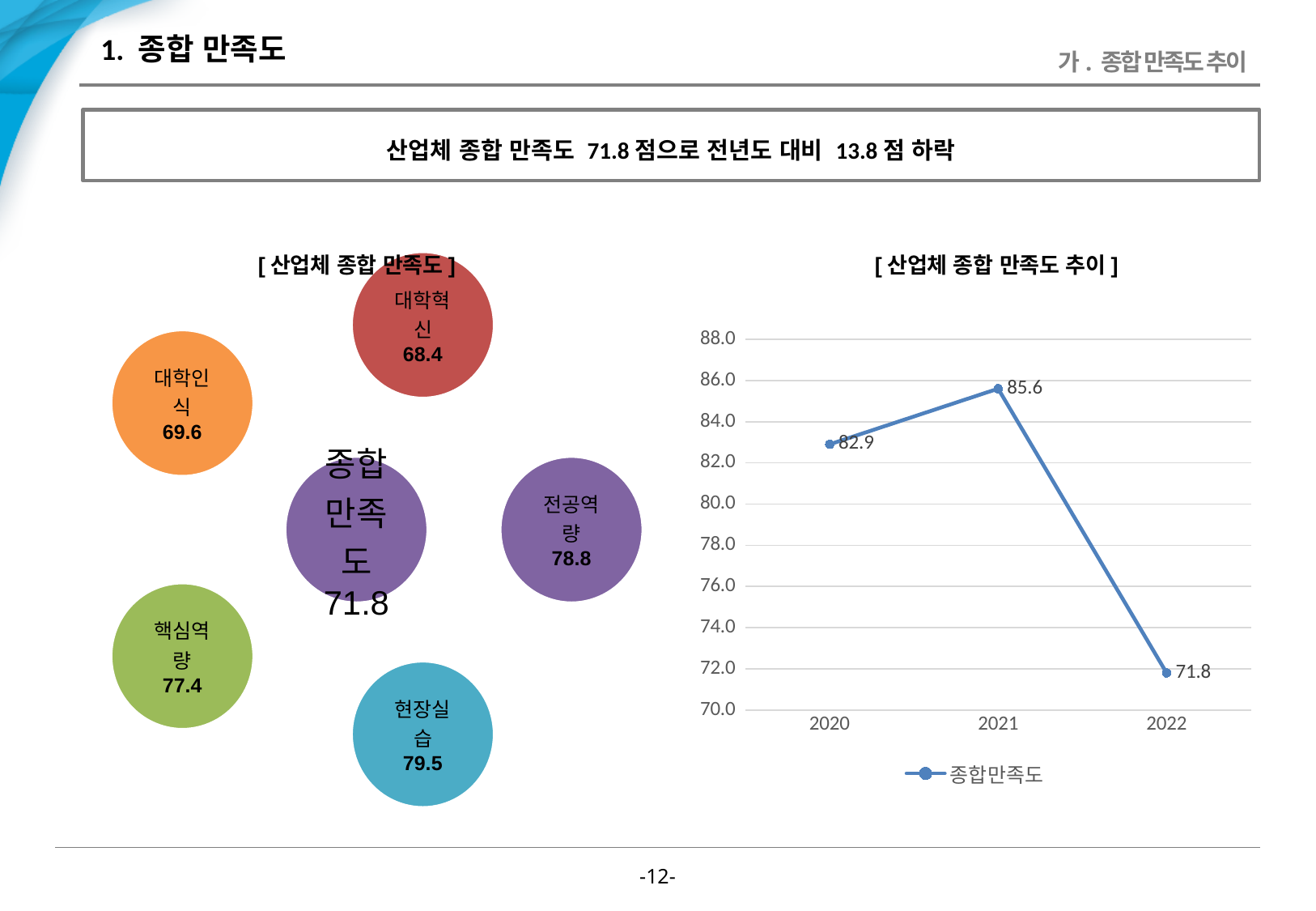
In the '[ 산업체 종합 만족도 추이 ]' chart, what is the value for 2022? 71.8 In the '[ 산업체 종합 만족도 추이 ]' chart, how many series does the legend list? 1 In the '[ 산업체 종합 만족도 추이 ]' chart, what is the value for 2020? 82.9 In the '[ 산업체 종합 만족도 추이 ]' chart, which year has the lowest value? 2022 In the '[ 산업체 종합 만족도 추이 ]' chart, what is the name of the series shown in the legend? 종합만족도 In the '[ 산업체 종합 만족도 추이 ]' chart, how many years are plotted? 3 In the '[ 산업체 종합 만족도 추이 ]' chart, what is the difference between the 2021 and 2022 values? 13.8 What kind of chart is the '[ 산업체 종합 만족도 추이 ]' chart? line chart In the '[ 산업체 종합 만족도 추이 ]' chart, which is larger, the value for 2020 or the value for 2022? 2020 In the '[ 산업체 종합 만족도 추이 ]' chart, which year has the highest value? 2021 In the '[ 산업체 종합 만족도 추이 ]' chart, what is the value for 2021? 85.6 In the '[ 산업체 종합 만족도 추이 ]' chart, does the value rise or fall from 2021 to 2022? fall